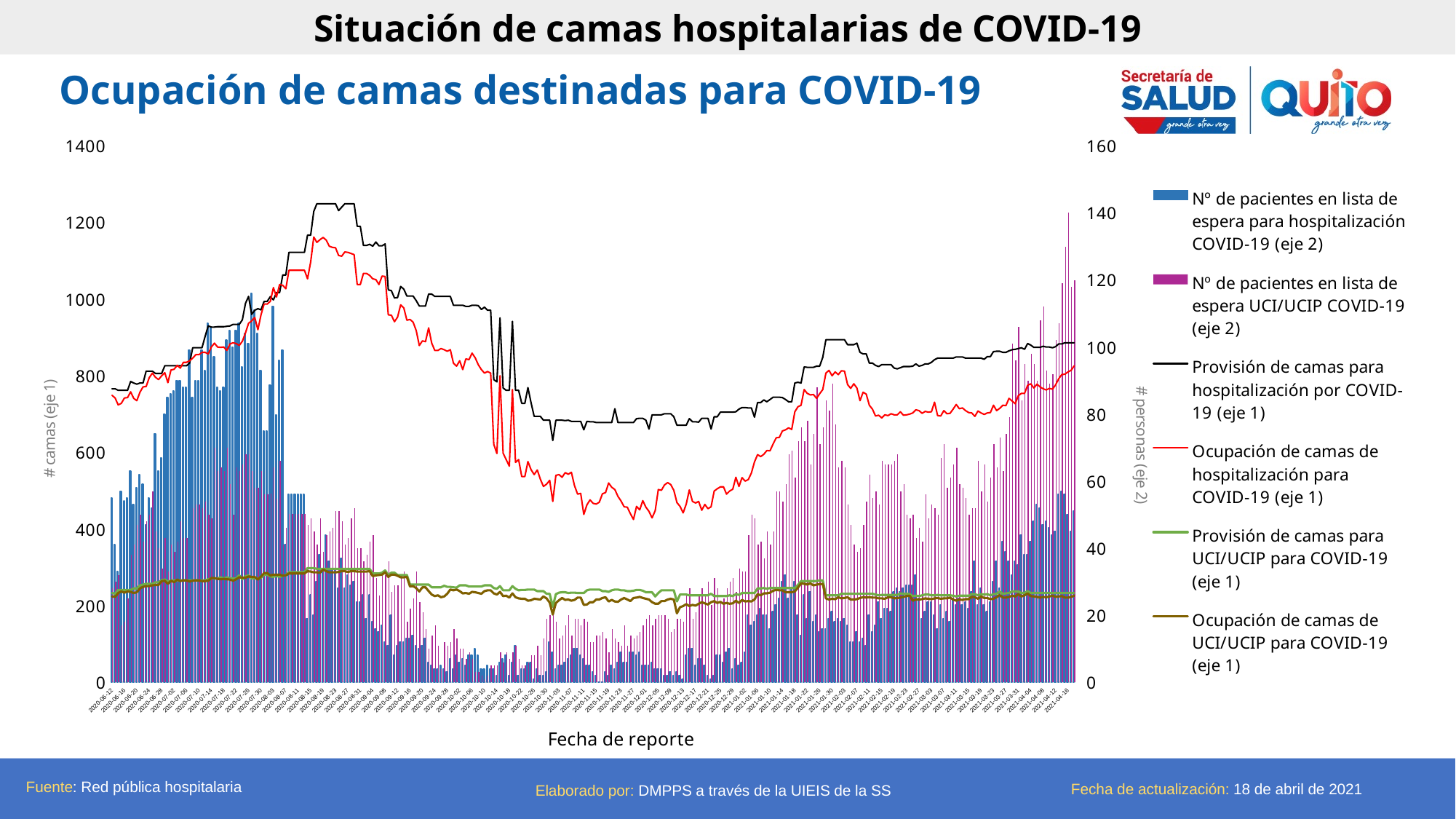
Is the highest bar for 'Nº de pacientes en lista de espera UCI/UCIP COVID-19 (eje 2)' near 2021-04-16 greater or less than 120 on the right axis? greater How many series does the chart legend list? 6 Is the peak value of 'Provisión de camas para hospitalización por COVID-19 (eje 1)' around 2020-08-19 greater or less than 1200? greater What is the label of the x axis of the chart? Fecha de reporte What is the title of the chart? Ocupación de camas destinadas para COVID-19 Does 'Provisión de camas para hospitalización por COVID-19 (eje 1)' rise or fall between 2020-06-12 and 2020-08-19? rise Does 'Ocupación de camas de hospitalización para COVID-19 (eje 1)' rise or fall between 2020-08-19 and 2020-11-27? fall Is the value of 'Provisión de camas para UCI/UCIP para COVID-19 (eje 1)' around 2020-08-19 greater or less than 200? greater What kind of chart is shown on the slide? Combined bar and line chart Around 2020-08-19, which is higher: 'Provisión de camas para hospitalización por COVID-19 (eje 1)' or 'Ocupación de camas de hospitalización para COVID-19 (eje 1)'? Provisión de camas para hospitalización por COVID-19 (eje 1)